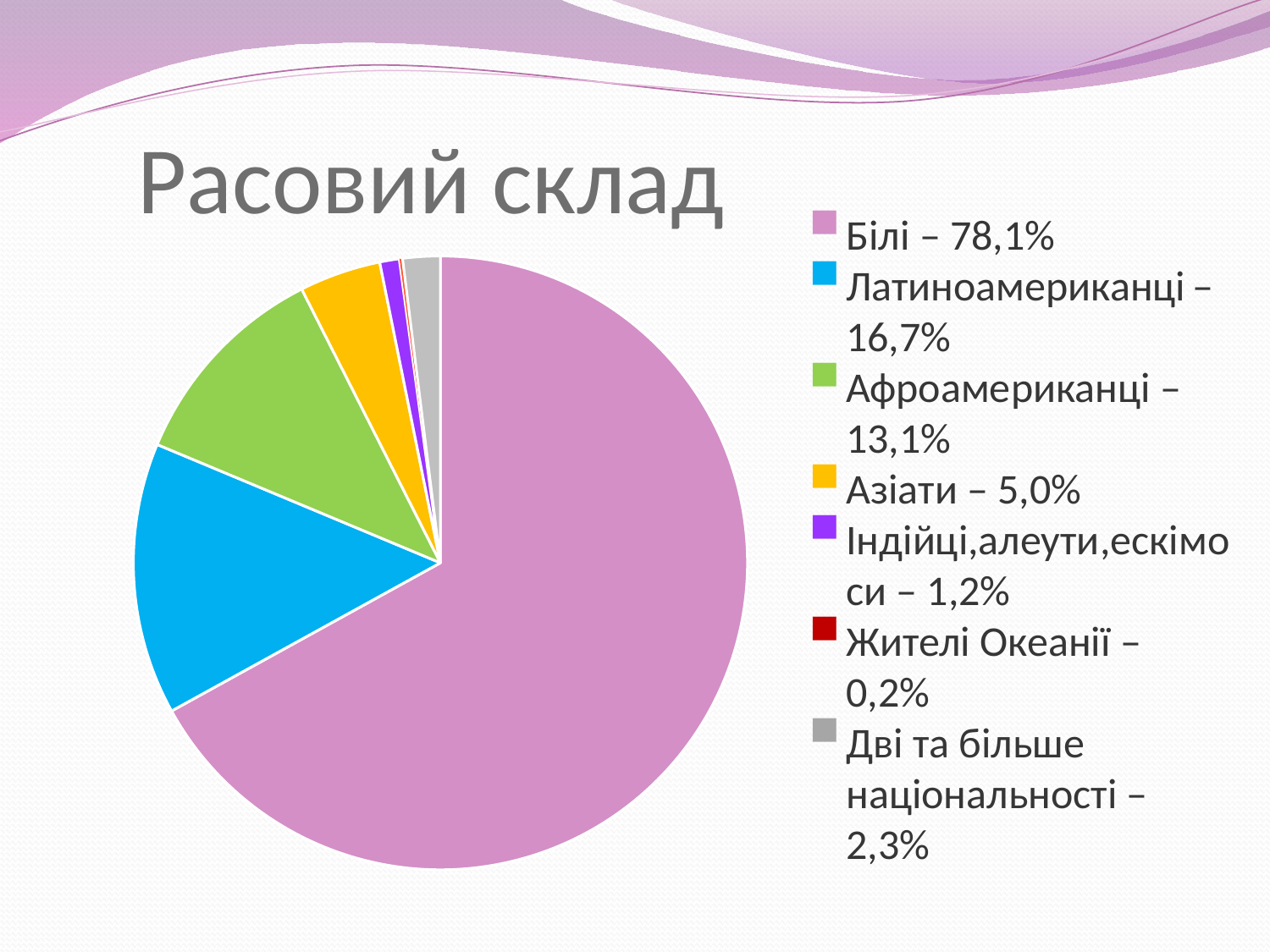
What percentage is shown for Дві та більше національності? 2,3% Which category has the smallest slice of the pie? Жителі Океанії How many entries does the legend list? 7 What percentage is shown for Жителі Океанії? 0,2% What is the title of the chart? Расовий склад What percentage is shown for Азіати? 5,0% What percentage is shown for Афроамериканці? 13,1% Which is larger, the share for Латиноамериканці or for Афроамериканці? Латиноамериканці What percentage is shown for Білі? 78,1% Which category has the largest slice of the pie? Білі What type of chart is shown on the slide? pie chart What percentage is shown for Латиноамериканці? 16,7%